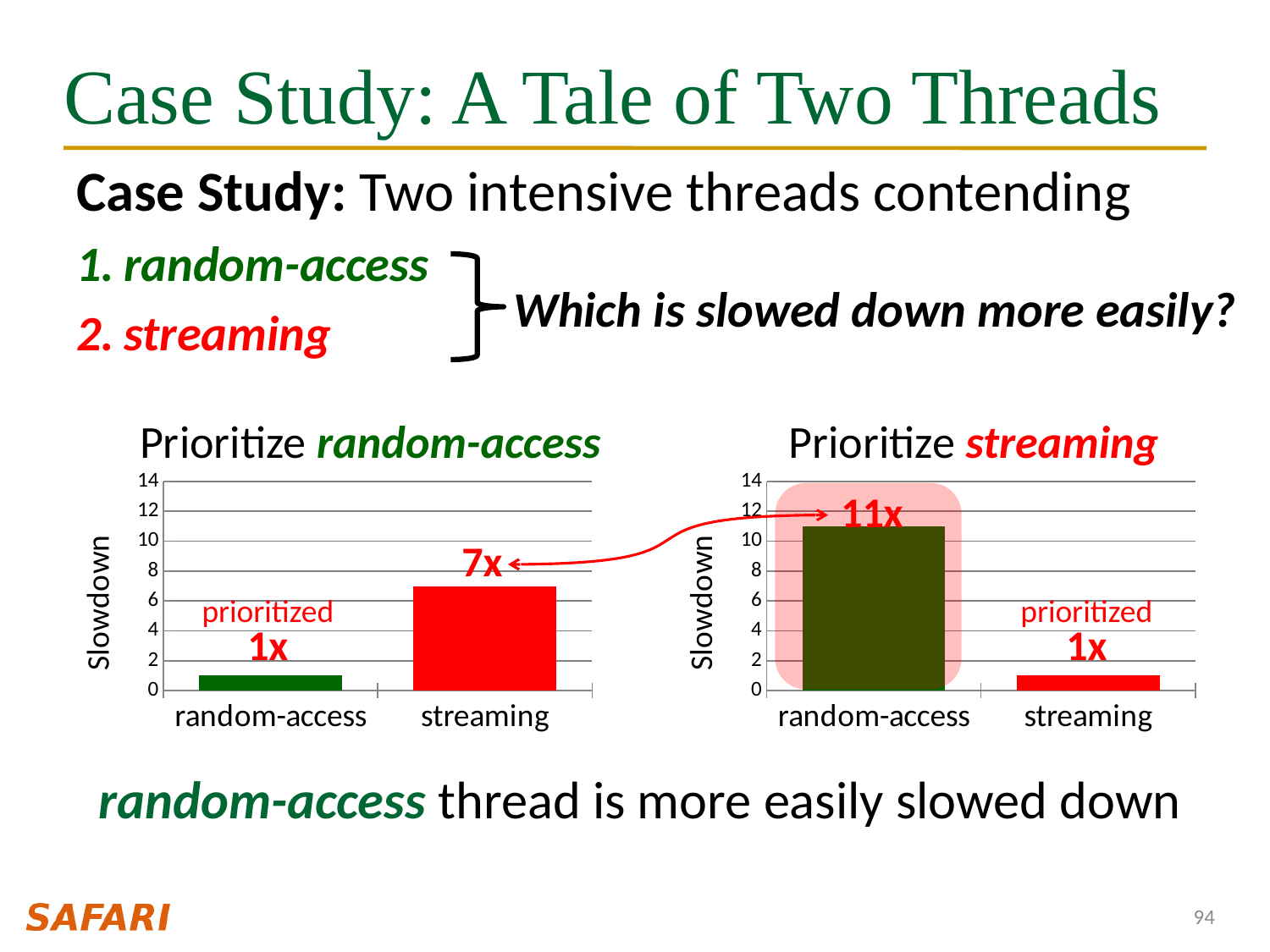
Is the slowdown of random-access in the 'Prioritize streaming' chart larger than the slowdown of streaming in the 'Prioritize random-access' chart? Yes In the 'Prioritize streaming' chart, what is the slowdown for streaming? 1x In the 'Prioritize random-access' chart, what is the difference between the slowdown of streaming and random-access? 6x In the 'Prioritize streaming' chart, what is the difference between the slowdown of random-access and streaming? 10x In the 'Prioritize random-access' chart, what is the slowdown for random-access? 1x In the 'Prioritize streaming' chart, which category has the lower slowdown? streaming What type of chart is the 'Prioritize streaming' chart? Bar chart How many categories are shown on the x axis of the 'Prioritize random-access' chart? 2 In the 'Prioritize streaming' chart, is the slowdown for random-access greater or less than 10? greater In the 'Prioritize streaming' chart, what is the slowdown for random-access? 11x In the 'Prioritize random-access' chart, which category has the higher slowdown? streaming In the 'Prioritize random-access' chart, what is the slowdown for streaming? 7x